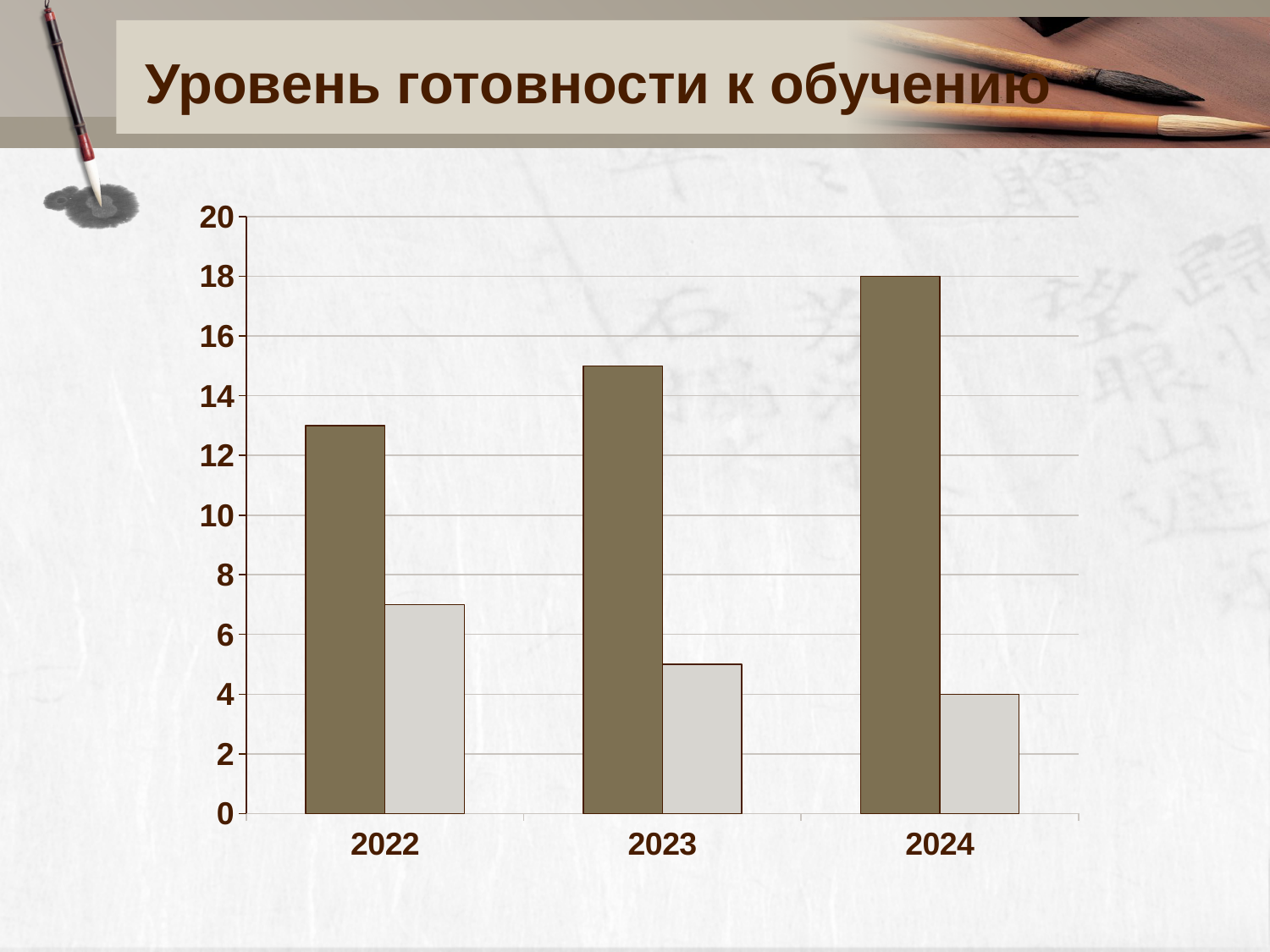
Is the value of the light grey bar for 2023 greater or less than 6? less Do the light grey bars rise or fall from 2022 to 2024? fall In which year is the dark brown bar the highest? 2024 What is the value of the dark brown bar for 2024? 18 What is the title of the chart? Уровень готовности к обучению In which year is the light grey bar the lowest? 2024 What is the value of the light grey bar for 2024? 4 What is the difference between the dark brown bar and the light grey bar for 2024? 14 What kind of chart is shown on the slide? bar chart Do the dark brown bars rise or fall from 2022 to 2024? rise How many years (categories) are shown on the x axis? 3 Is the value of the dark brown bar for 2022 greater or less than 12? greater